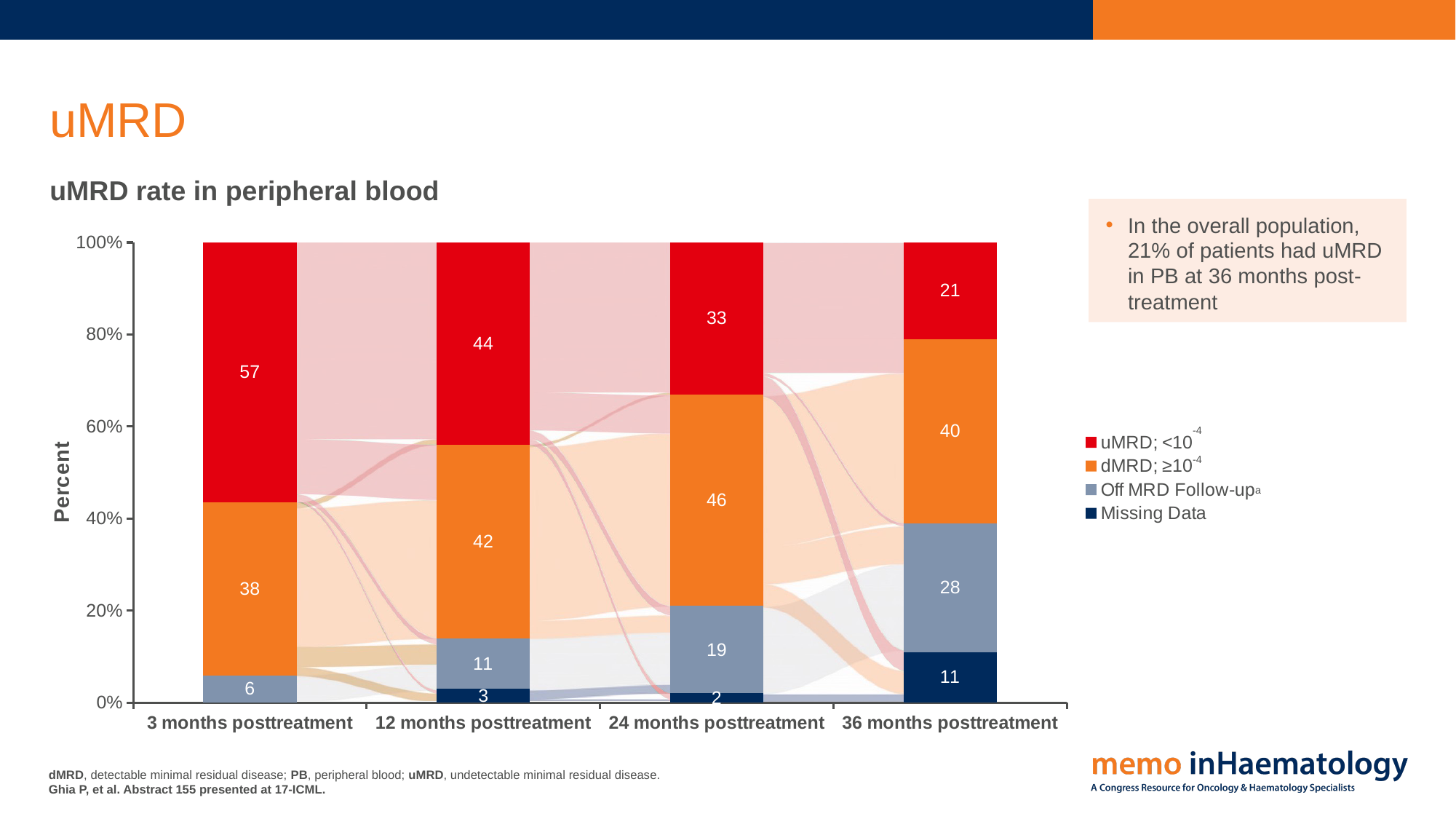
What is the Missing Data value at 12 months posttreatment? 3 Which is larger at 24 months posttreatment: the uMRD; <10-4 value or the dMRD; ≥10-4 value? dMRD; ≥10-4 At which time point is the uMRD; <10-4 value highest? 3 months posttreatment At which time point is the Off MRD Follow-up value lowest? 3 months posttreatment What is the Off MRD Follow-up value at 36 months posttreatment? 28 How many time points are shown on the x axis? 4 Does the uMRD; <10-4 value rise or fall from 3 months to 36 months posttreatment? Fall What kind of chart is shown on the slide? Stacked bar chart What is the uMRD; <10-4 value at 3 months posttreatment? 57 What is the difference between the uMRD; <10-4 values at 3 months and 36 months posttreatment? 36 How many series does the legend list? 4 What is the dMRD; ≥10-4 value at 24 months posttreatment? 46